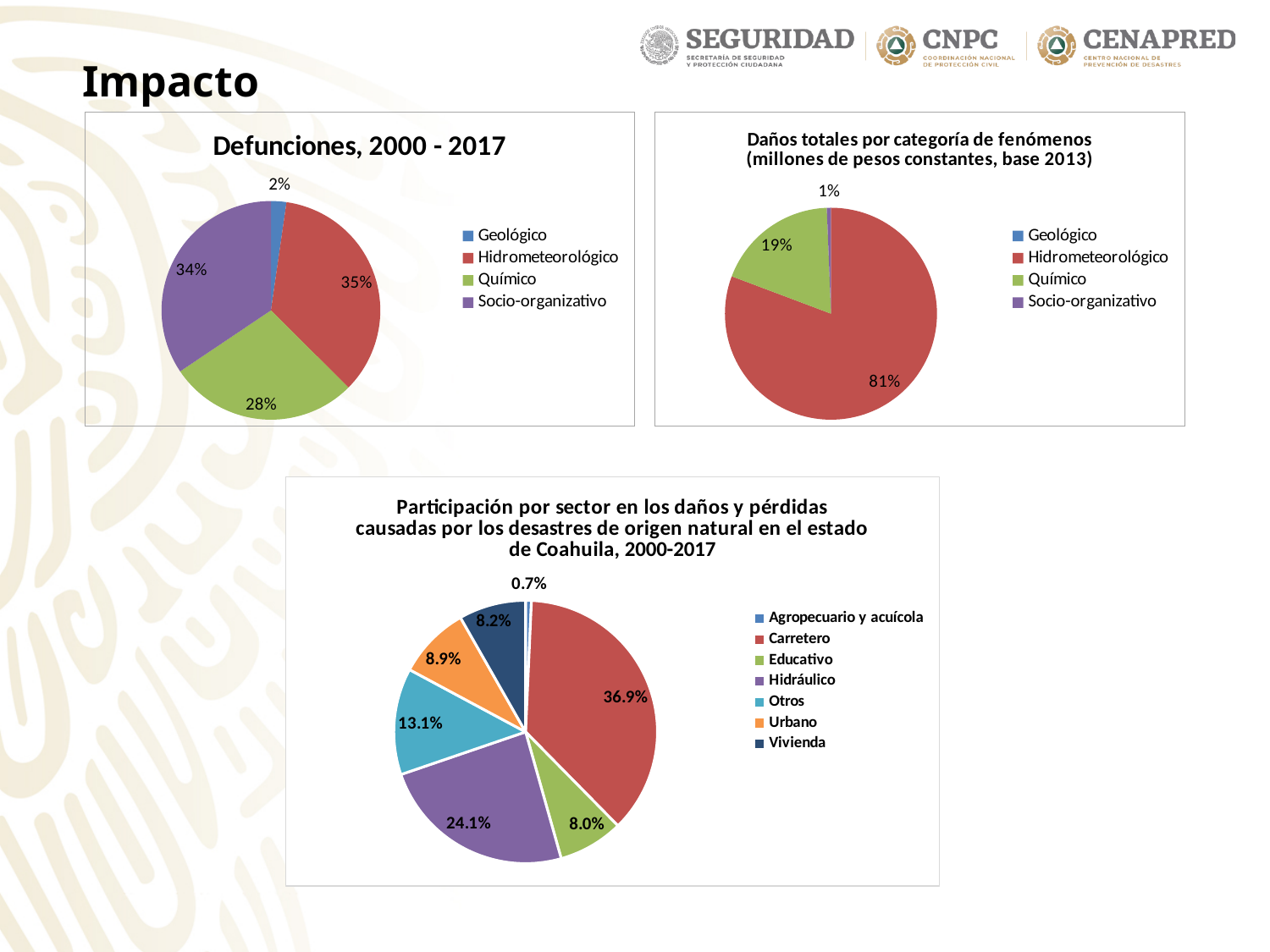
In the 'Participación por sector' chart, which sector has the largest share? Carretero In the 'Participación por sector' chart, how many sectors does the legend list? 7 In the 'Defunciones, 2000 - 2017' chart, which category has the smallest share? Geológico In the 'Defunciones, 2000 - 2017' chart, what share is Hidrometeorológico? 35% In the 'Defunciones, 2000 - 2017' chart, what is the difference between the Socio-organizativo and Químico shares? 6% In the 'Participación por sector' chart, which is larger, Urbano or Vivienda? Urbano In the 'Daños totales por categoría de fenómenos' chart, what share is Hidrometeorológico? 81% In the 'Daños totales por categoría de fenómenos' chart, which category has the largest share? Hidrometeorológico In the 'Daños totales por categoría de fenómenos' chart, what share is Químico? 19% What kind of chart is the 'Participación por sector' chart at the bottom of the slide? Pie chart In the 'Defunciones, 2000 - 2017' chart, how many categories does the legend list? 4 In the 'Participación por sector' chart, what share is Hidráulico? 24.1%